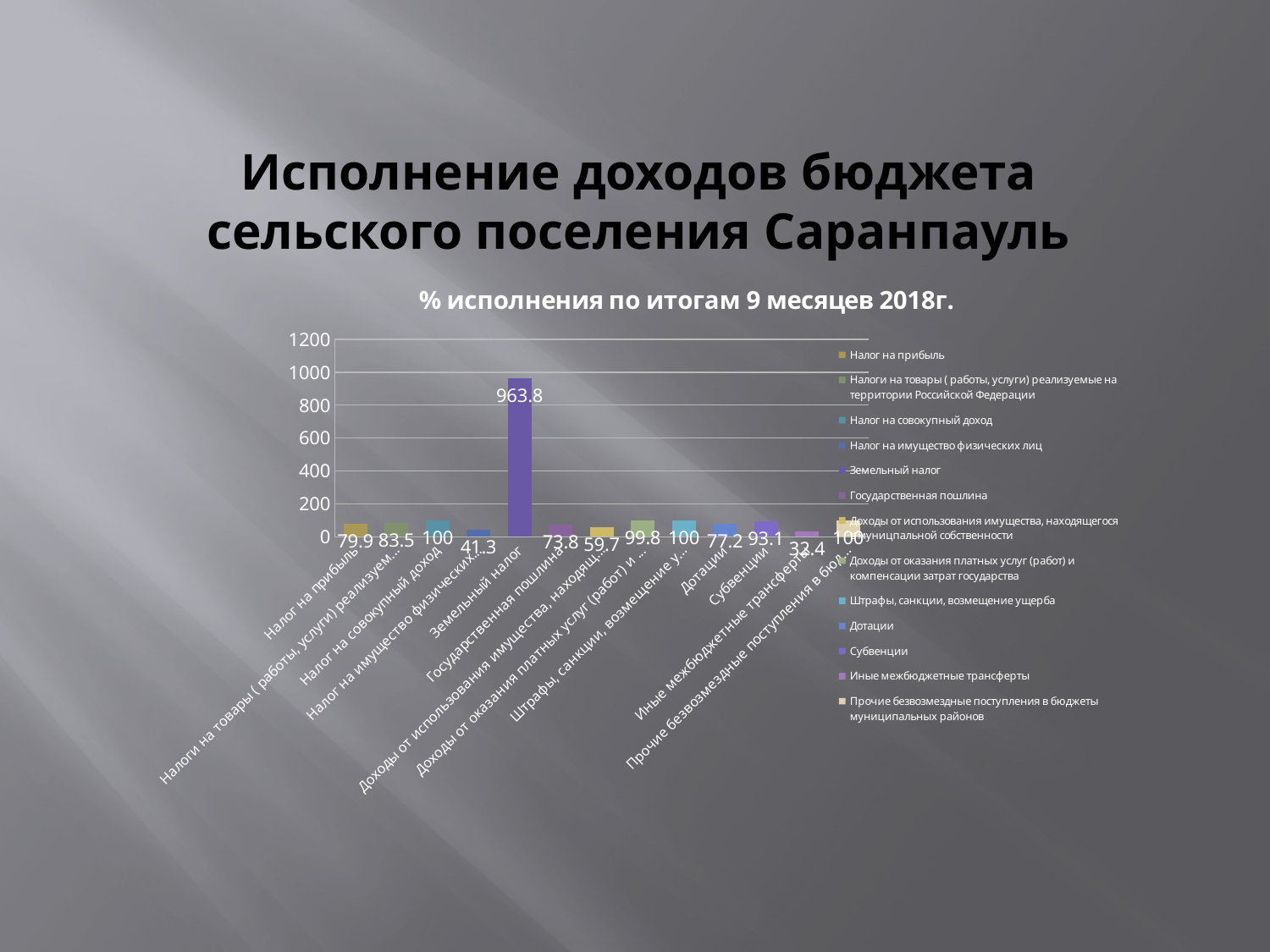
What is the value for Субвенции? 93.1 Which is larger, the value for Налог на прибыль or the value for Государственная пошлина? Налог на прибыль What is the value for Дотации? 77.2 What is the value for Налог на прибыль? 79.9 What is the value for Налог на совокупный доход? 100 How many entries does the legend list? 13 Which category has the lowest value? Иные межбюджетные трансферты What type of chart is shown on the slide? bar chart What is the value for Земельный налог? 963.8 What is the title of the chart? % исполнения по итогам 9 месяцев 2018г. Which category has the highest value? Земельный налог What is the difference between the values for Субвенции and Дотации? 15.9